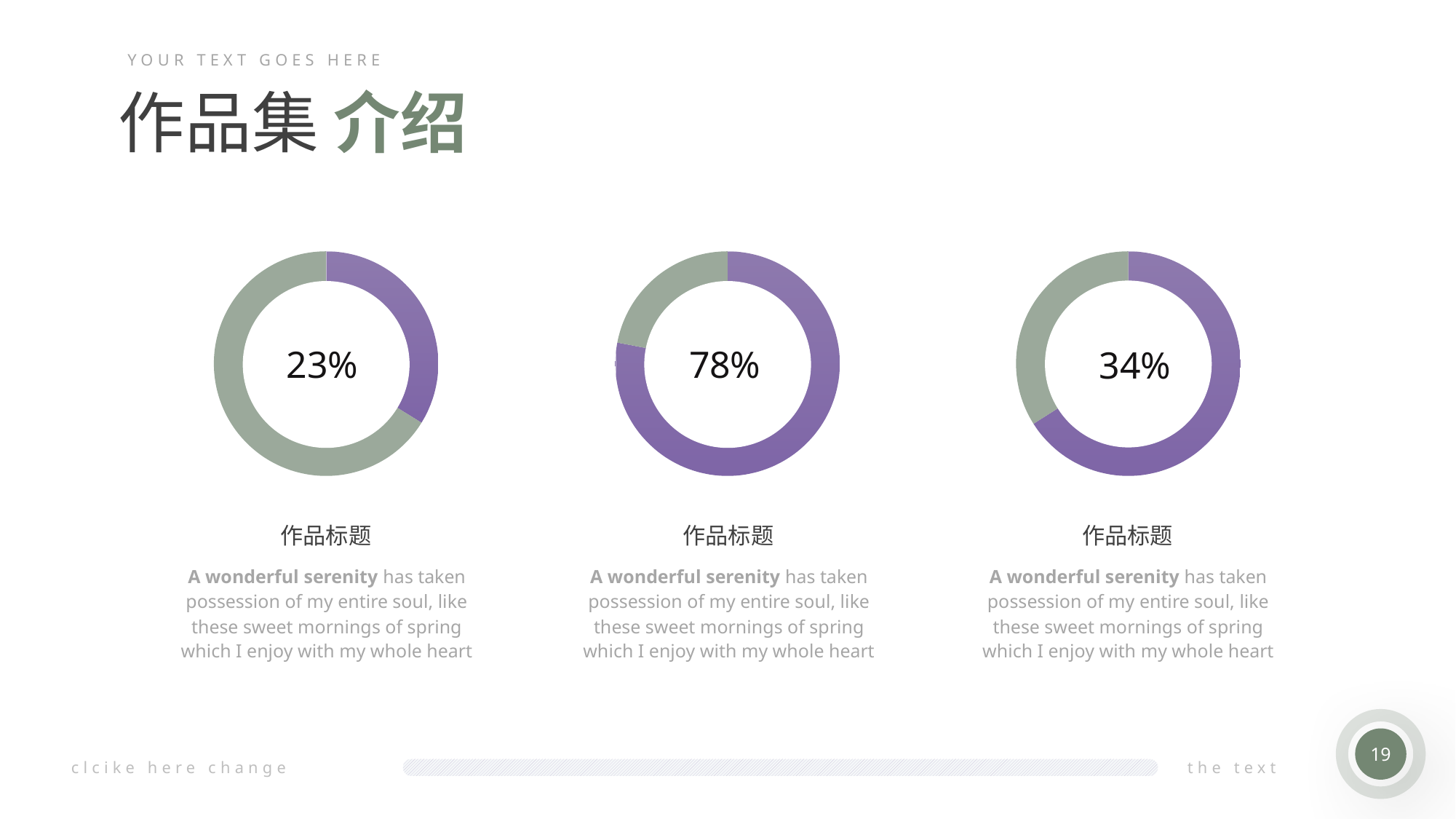
What percentage is shown in the centre of the middle donut chart? 78% What percentage is shown in the centre of the right donut chart? 34% In the middle donut chart, what share of the ring is not filled by the purple segment? 22% Which of the three donut charts shows the lowest percentage? The left chart (23%) What is the difference between the percentage in the middle donut chart and the percentage in the left donut chart? 55% How many donut charts are on the slide? 3 What percentage is shown in the centre of the left donut chart? 23% What is the difference between the percentage in the right donut chart and the percentage in the left donut chart? 11% Which of the three donut charts shows the highest percentage? The middle chart (78%) What kind of chart is used three times on this slide? Donut chart Is the percentage in the right donut chart larger or smaller than the percentage in the middle donut chart? Smaller